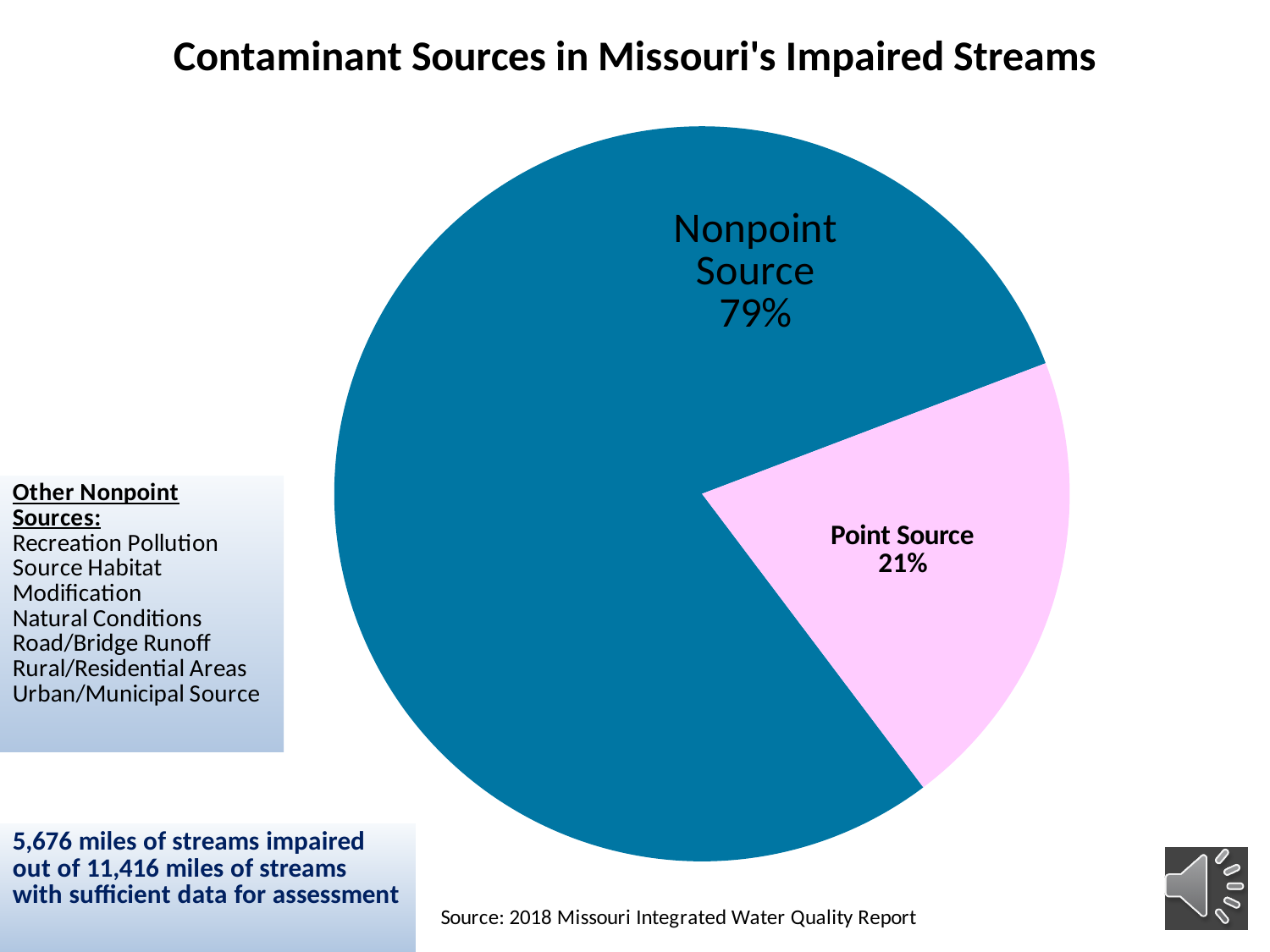
What is the total of the two slices' percentages? 100% What is the title of the chart? Contaminant Sources in Missouri's Impaired Streams How many slices does the pie chart have? 2 What is the difference in percentage points between Nonpoint Source and Point Source? 58 Which slice of the pie is the largest? Nonpoint Source Is the share for Point Source greater or less than 50%? less What type of chart is shown on the slide? Pie chart What colour is the Point Source slice? Pink What share of the pie is Point Source? 21% Which slice of the pie is the smallest? Point Source Which is larger, the Nonpoint Source slice or the Point Source slice? Nonpoint Source What share of the pie is Nonpoint Source? 79%